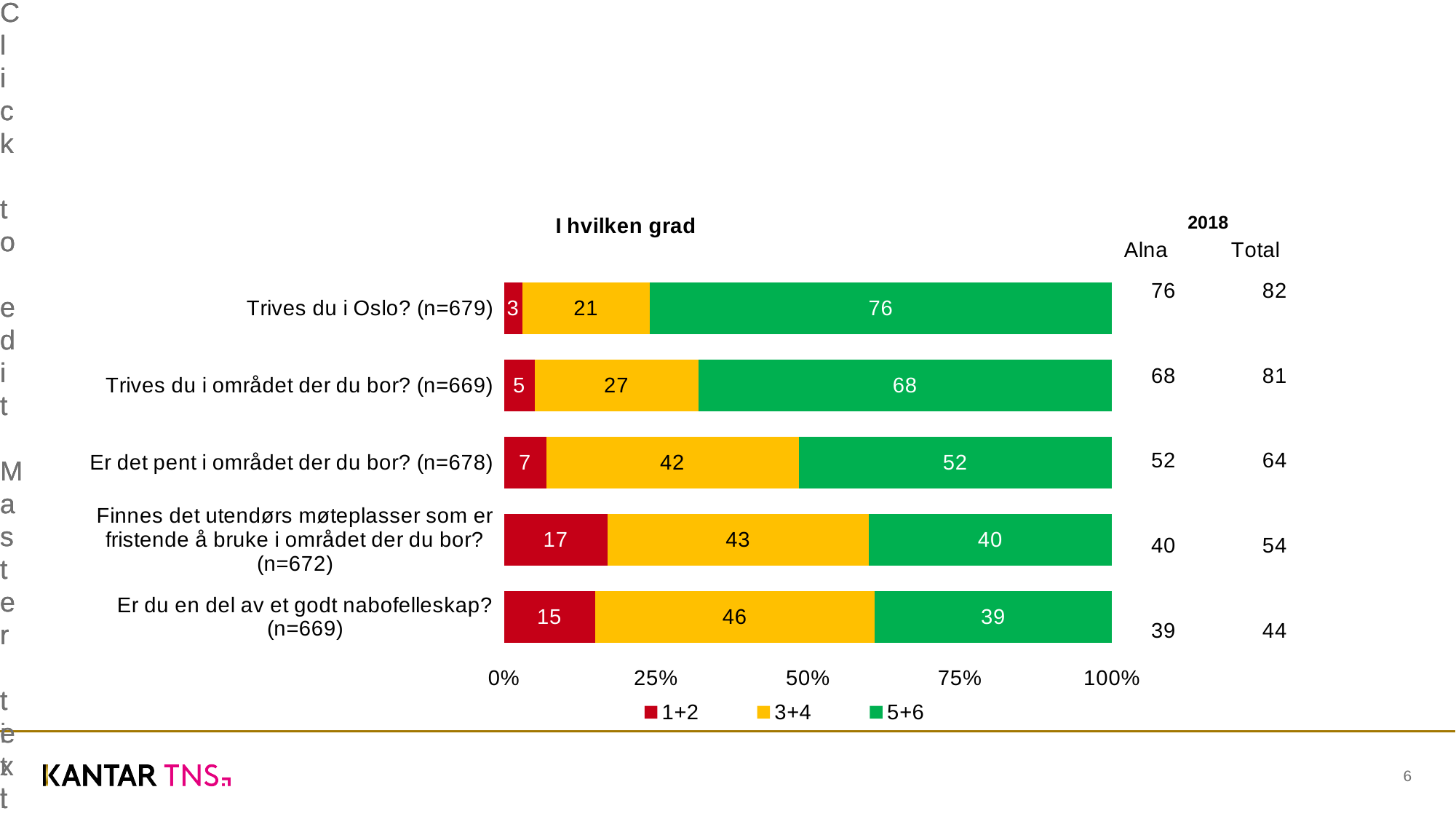
Which category has the lowest 5+6 value? Er du en del av et godt nabofelleskap? (n=669) Which is larger: the 3+4 value for "Er du en del av et godt nabofelleskap?" or the 3+4 value for "Finnes det utendørs møteplasser som er fristende å bruke i området der du bor?"? Er du en del av et godt nabofelleskap? What kind of chart is shown on the slide? Stacked bar chart Which category has the highest 5+6 value? Trives du i Oslo? (n=679) What is the 3+4 value for "Er det pent i området der du bor? (n=678)"? 42 What is the difference between the 5+6 values for "Trives du i Oslo?" and "Trives du i området der du bor?"? 8 What is the title of the chart? I hvilken grad What is the 1+2 value for "Finnes det utendørs møteplasser som er fristende å bruke i området der du bor? (n=672)"? 17 How many question categories are plotted in the chart? 5 What is the 5+6 value for "Trives du i Oslo? (n=679)"? 76 How many series does the legend list? 3 What is the 2018 Total value shown for "Er det pent i området der du bor?"? 64